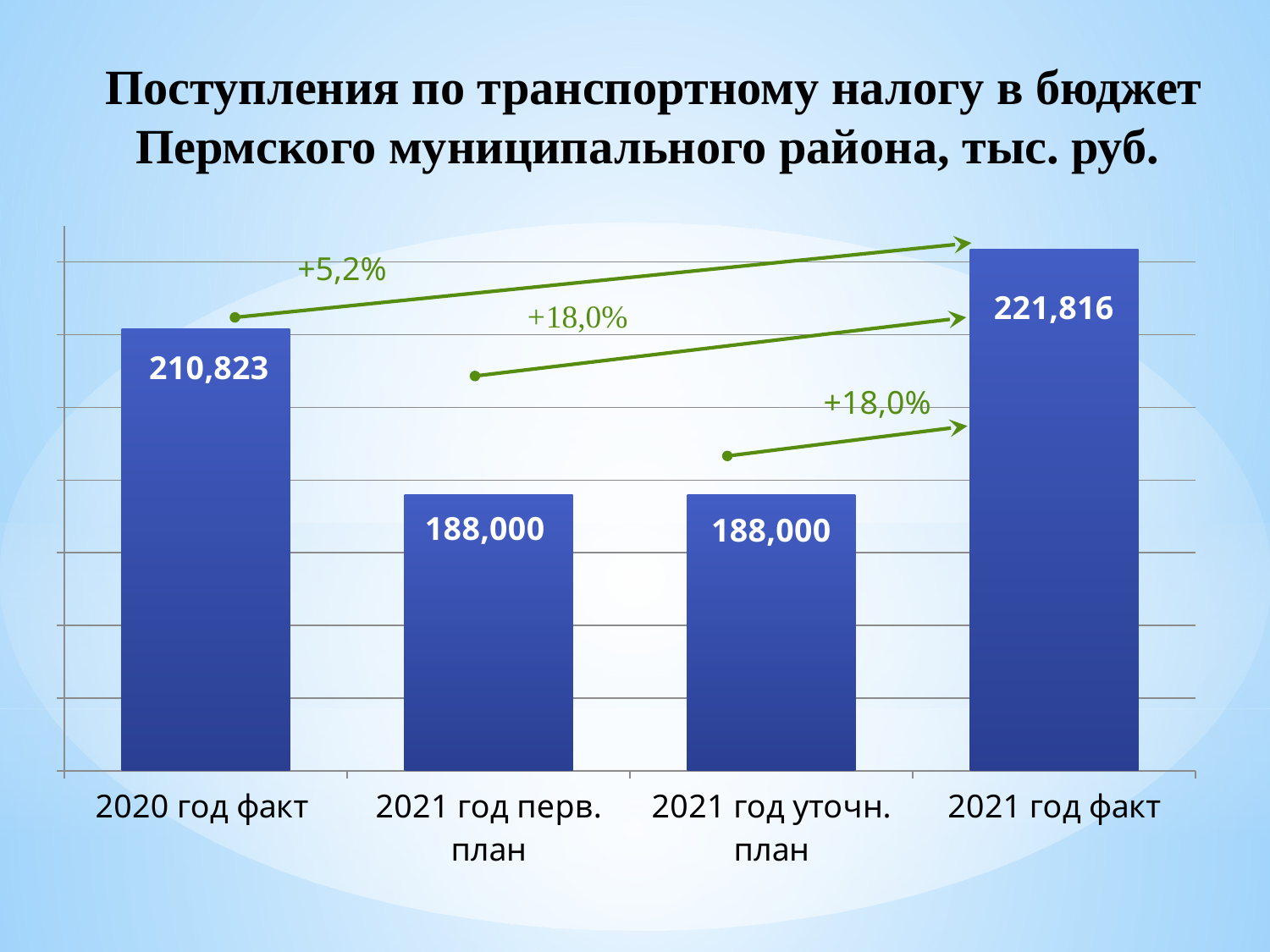
Which is larger, the value for 2020 год факт or the value for 2021 год факт? 2021 год факт What is the value for 2020 год факт? 210,823 What is the value for 2021 год перв. план? 188,000 Which category has the highest value? 2021 год факт How many categories are shown on the x axis? 4 What is the difference between the values for 2020 год факт and 2021 год перв. план? 22,823 What is the difference between the values for 2021 год факт and 2020 год факт? 10,993 What is the value for 2021 год факт? 221,816 What is the value for 2021 год уточн. план? 188,000 What percentage change is annotated between 2020 год факт and 2021 год факт? +5,2% What is the difference between the values for 2021 год факт and 2021 год уточн. план? 33,816 What kind of chart is shown on the slide? bar chart